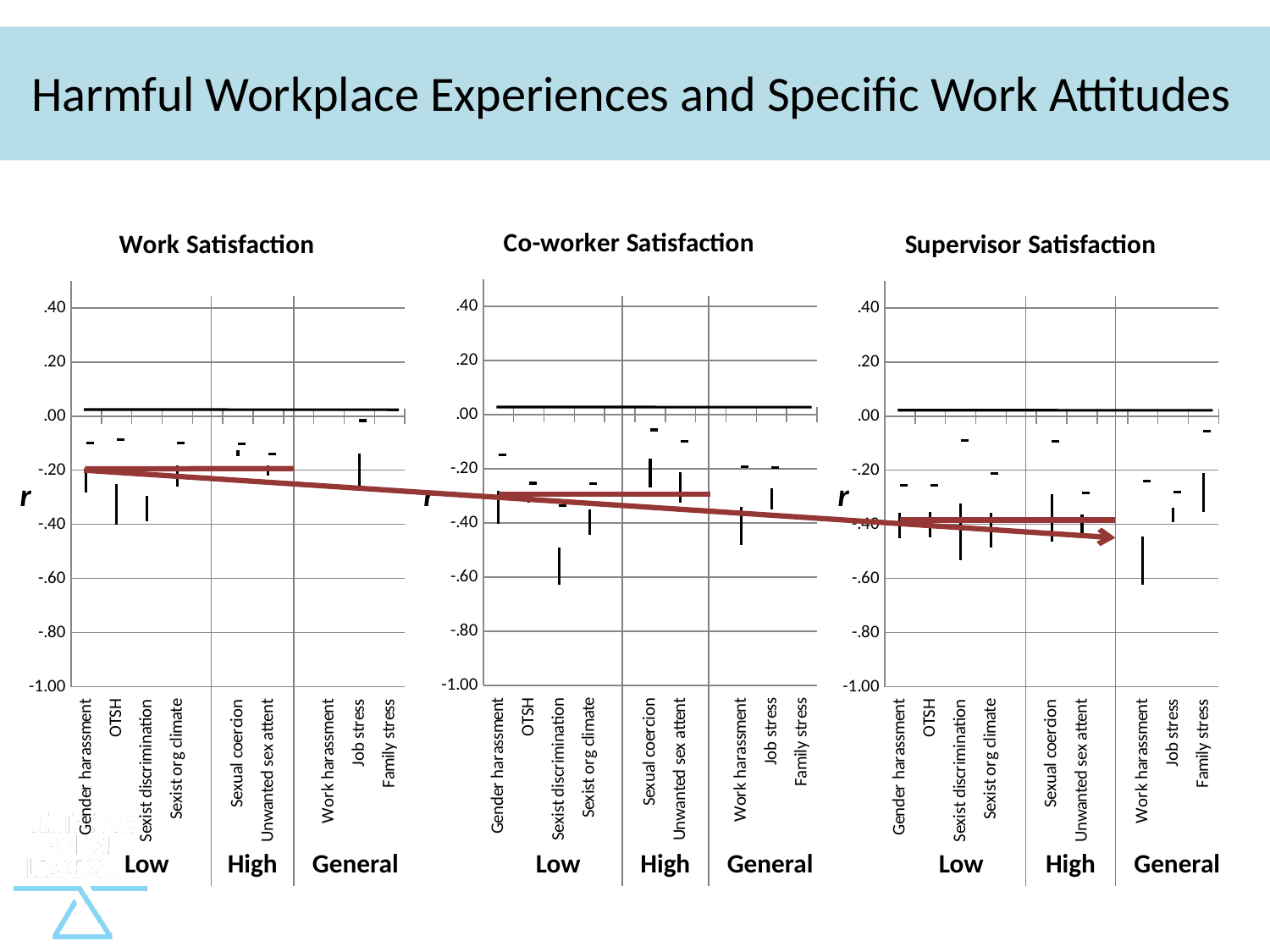
How many charts are shown on the slide? 3 In the Co-worker Satisfaction chart, how many groups (Low, High, General) are the categories divided into? 3 In the Work Satisfaction chart, is the value for Sexist discrimination greater or less than -.20? less In the Co-worker Satisfaction chart, is the value for Sexual coercion greater or less than -.40? greater In the Work Satisfaction chart, how many harmful workplace experience categories are listed along the x axis? 9 What is the label on the y axis of the Work Satisfaction chart? r In the Supervisor Satisfaction chart, is the value for Sexist discrimination greater or less than -.20? less What is the lowest tick value shown on the y axis of the Supervisor Satisfaction chart? -1.00